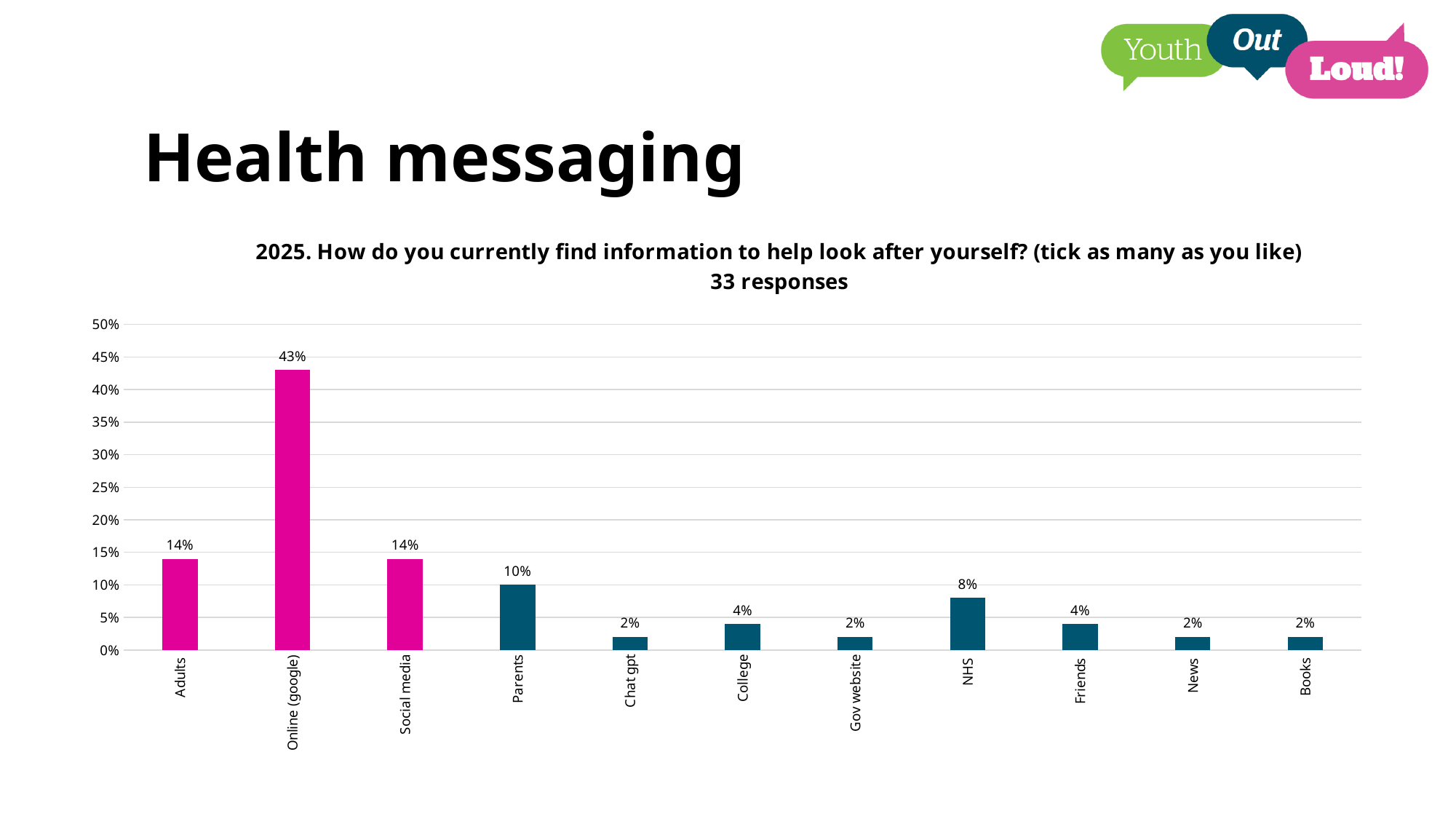
Which categories have bars coloured pink rather than dark blue? Adults, Online (google), Social media What is the value for NHS? 8% Is the value for Online (google) greater or less than 40%? greater Which is larger, the value for College or the value for NHS? NHS What is the difference between the values for Parents and NHS? 2% How many categories are shown on the x axis? 11 How many responses does the chart title say were collected? 33 responses What is the value for Parents? 10% What is the difference between the values for Online (google) and Social media? 29% Which category has the highest value? Online (google) What kind of chart is shown on the slide? Bar chart What percentage of respondents find information online (google)? 43%